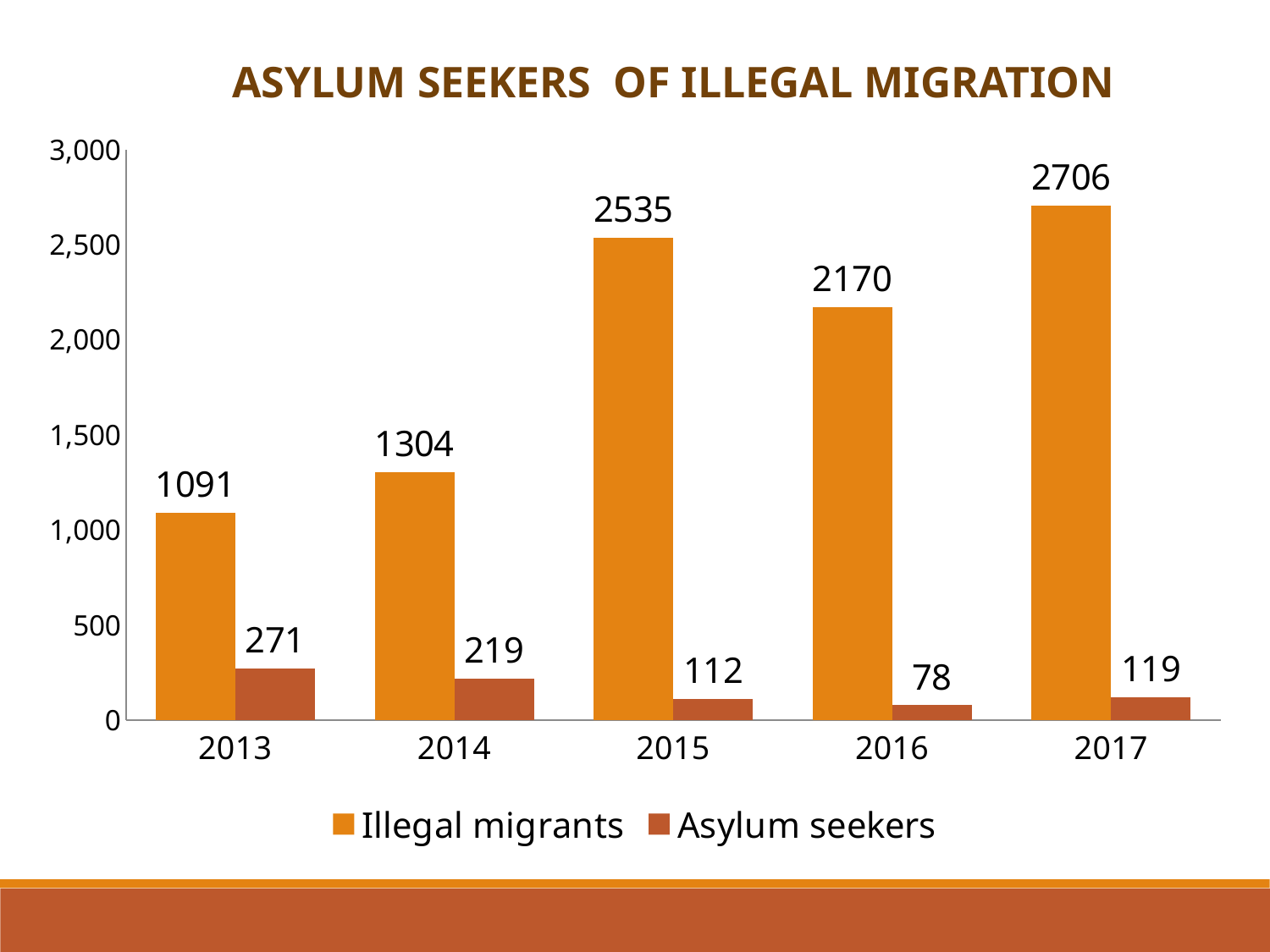
What is the difference between Illegal migrants in 2017 and in 2016? 536 Which year has the highest value for Illegal migrants? 2017 How many years are shown on the x axis? 5 What is the value for Asylum seekers in 2013? 271 What kind of chart is shown on the slide? Bar chart What is the difference between Asylum seekers in 2013 and in 2014? 52 Which year has the lowest value for Asylum seekers? 2016 What is the value for Asylum seekers in 2016? 78 What is the title of the chart? ASYLUM SEEKERS OF ILLEGAL MIGRATION How many series does the legend list? 2 What is the value for Illegal migrants in 2015? 2535 Which is larger, Illegal migrants in 2014 or Illegal migrants in 2013? 2014